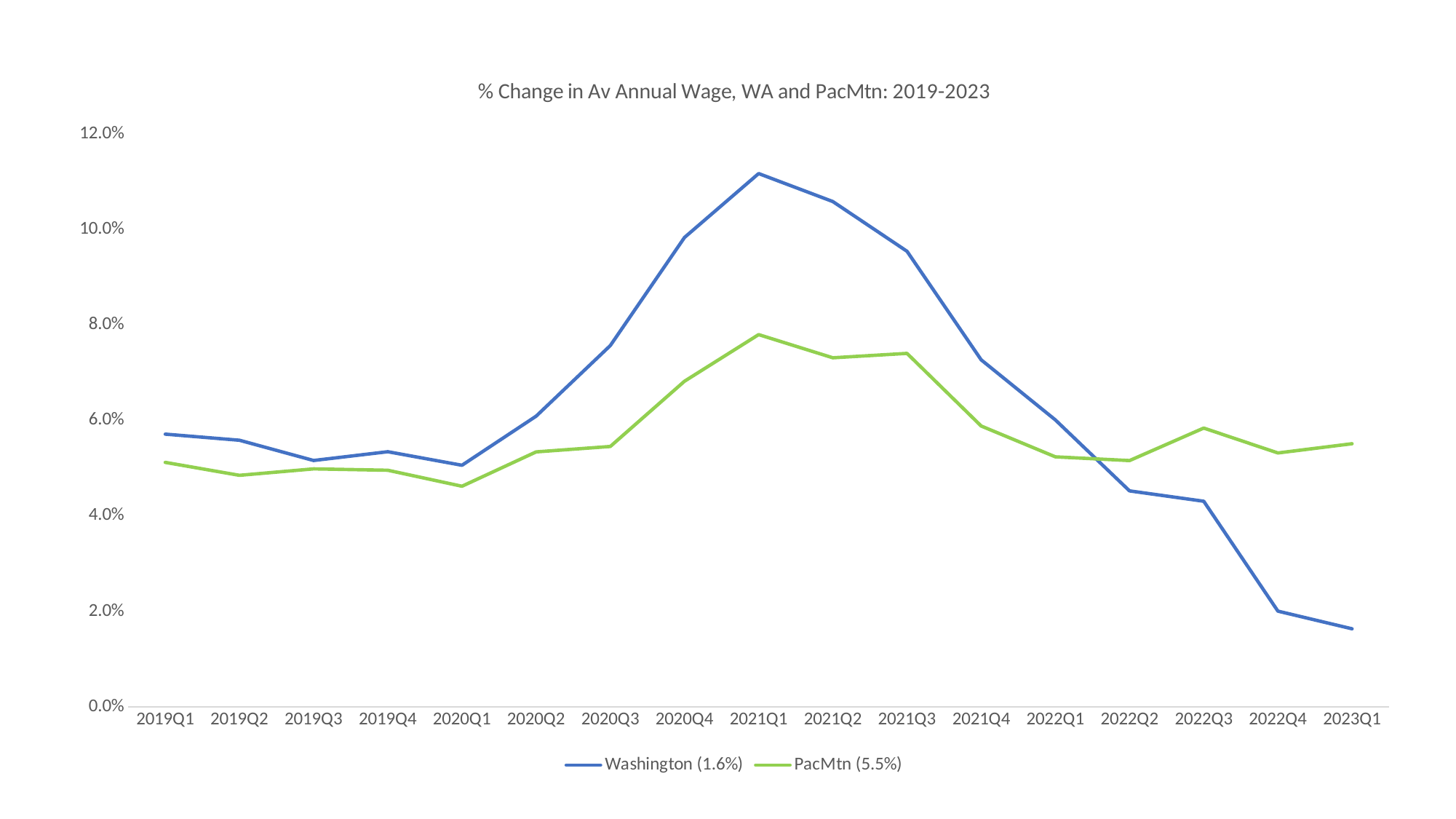
In 2021Q3, which series has the larger value, Washington or PacMtn? Washington In which quarter does the Washington series reach its highest value? 2021Q1 Is the PacMtn value for 2020Q1 greater or less than 5.0%? less In 2022Q4, which series has the larger value, Washington or PacMtn? PacMtn Does the Washington series rise or fall from 2021Q1 to 2023Q1? fall How many series does the legend list? 2 What is the title of the chart? % Change in Av Annual Wage, WA and PacMtn: 2019-2023 Is the Washington value for 2021Q1 greater or less than 10.0%? greater In which quarter is the Washington series at its lowest value? 2023Q1 How many quarters are plotted along the x axis? 17 What kind of chart is shown on the slide? line chart In which quarter does the PacMtn series reach its highest value? 2021Q1